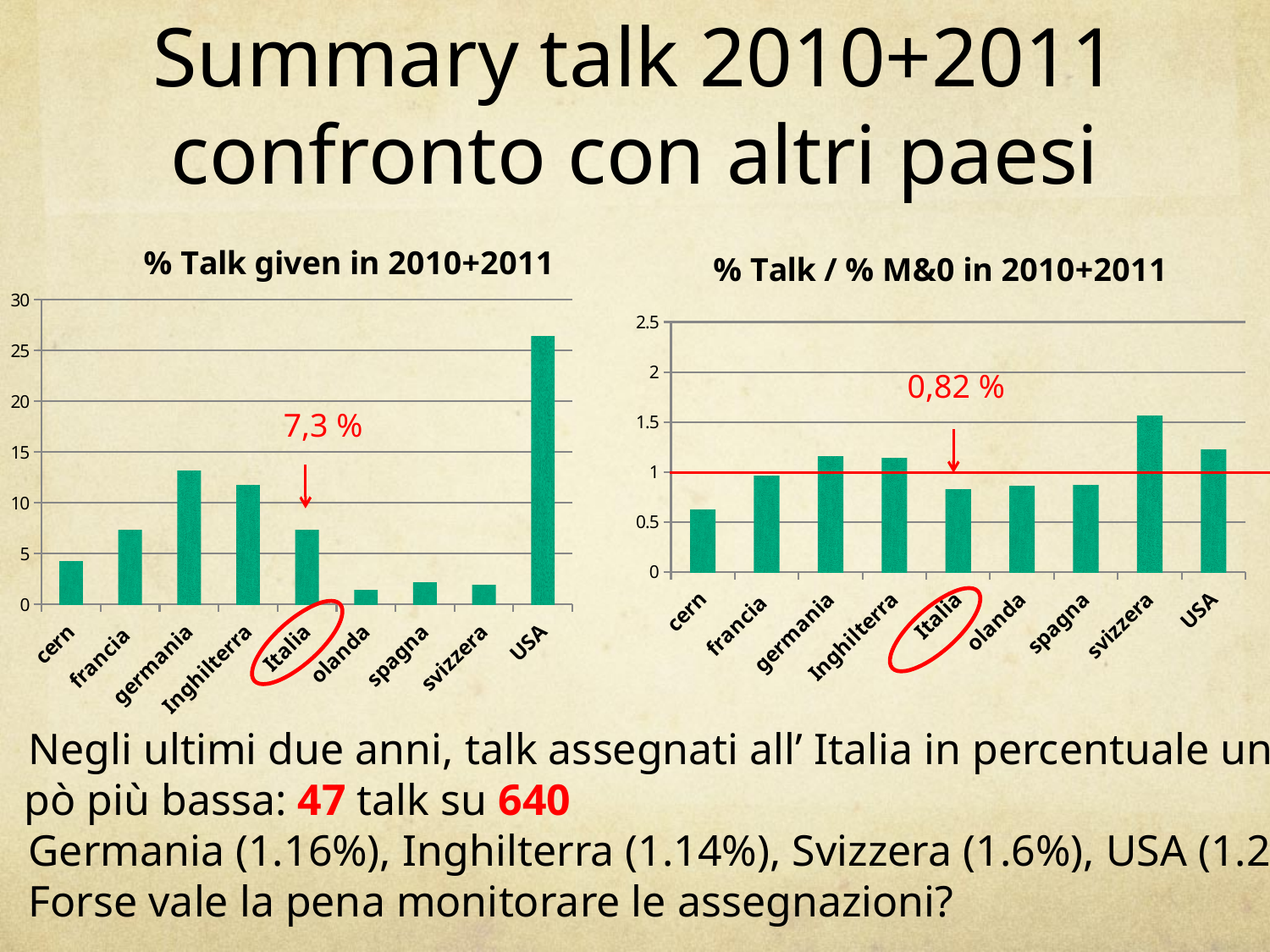
In the right chart '% Talk / % M&0 in 2010+2011', which category has the highest value? svizzera In the left chart '% Talk given in 2010+2011', which is larger, germania or Inghilterra? germania What kind of chart is the left chart titled '% Talk given in 2010+2011'? bar chart In the left chart '% Talk given in 2010+2011', which category has the highest value? USA What is the title of the right chart on the slide? % Talk / % M&0 in 2010+2011 In the left chart '% Talk given in 2010+2011', what value is annotated for Italia? 7,3 % In the right chart '% Talk / % M&0 in 2010+2011', is the value for USA greater or less than 1? greater In the left chart '% Talk given in 2010+2011', which category has the lowest value? olanda In the left chart '% Talk given in 2010+2011', is the value for USA greater or less than 25? greater In the right chart '% Talk / % M&0 in 2010+2011', what value is annotated for Italia? 0,82 % In the right chart '% Talk / % M&0 in 2010+2011', which category has the lowest value? cern How many categories are shown on the x axis of the left chart '% Talk given in 2010+2011'? 9